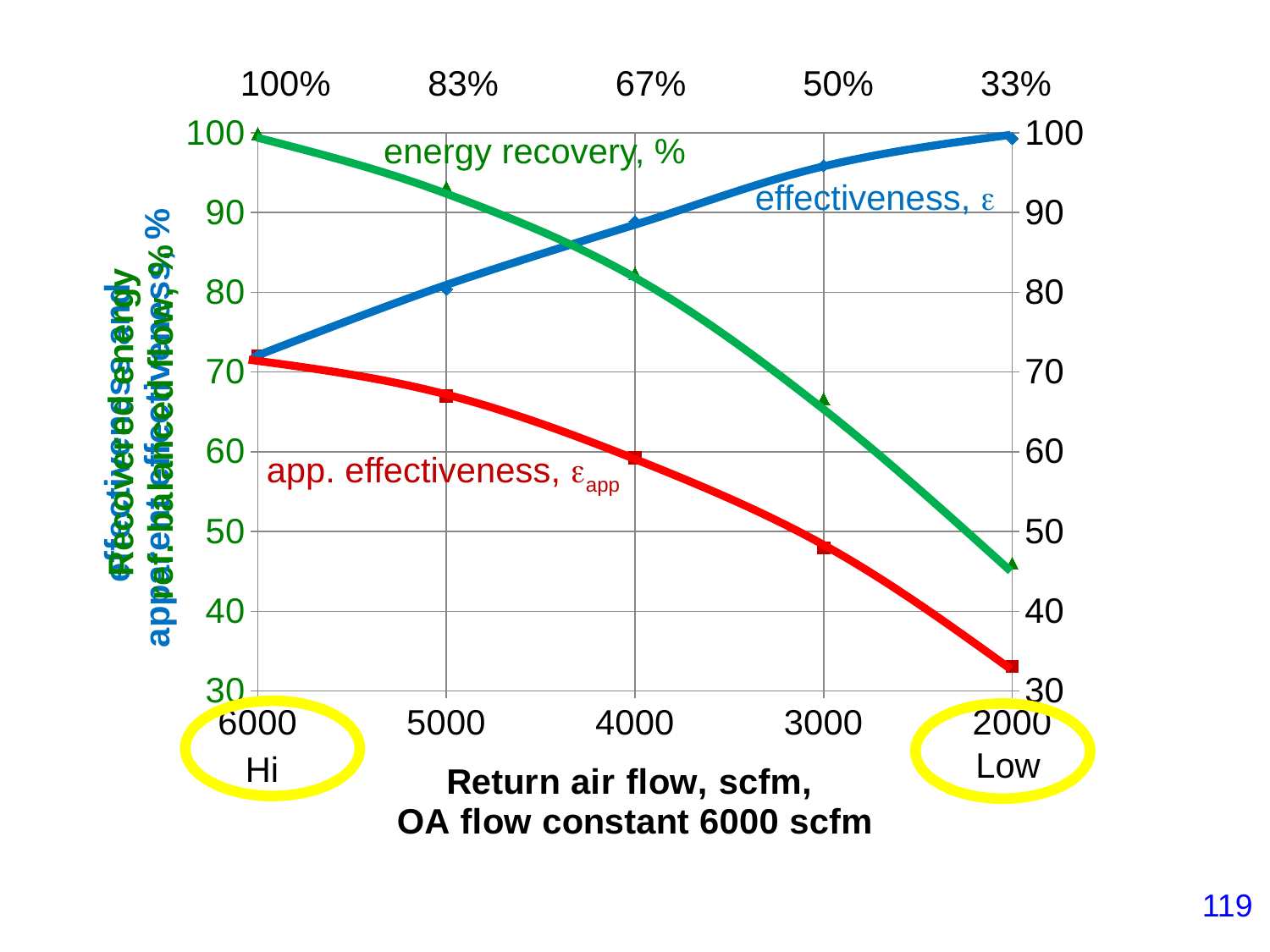
What colour is the energy recovery line? green At a return air flow of 4000 scfm, which is larger: effectiveness or energy recovery? effectiveness What kind of chart is shown on the slide? line chart Does the energy recovery line rise or fall as return air flow goes from 6000 to 2000 scfm? fall How many series are plotted on the chart? 3 Is the effectiveness value at a return air flow of 3000 scfm greater or less than 90? greater Is the app. effectiveness value at a return air flow of 2000 scfm greater or less than 40? less Is the energy recovery value at a return air flow of 2000 scfm greater or less than 50? less At a return air flow of 5000 scfm, which is larger: energy recovery or app. effectiveness? energy recovery Does the effectiveness line rise or fall as return air flow goes from 6000 to 2000 scfm? rise How many return air flow values are marked on the x axis? 5